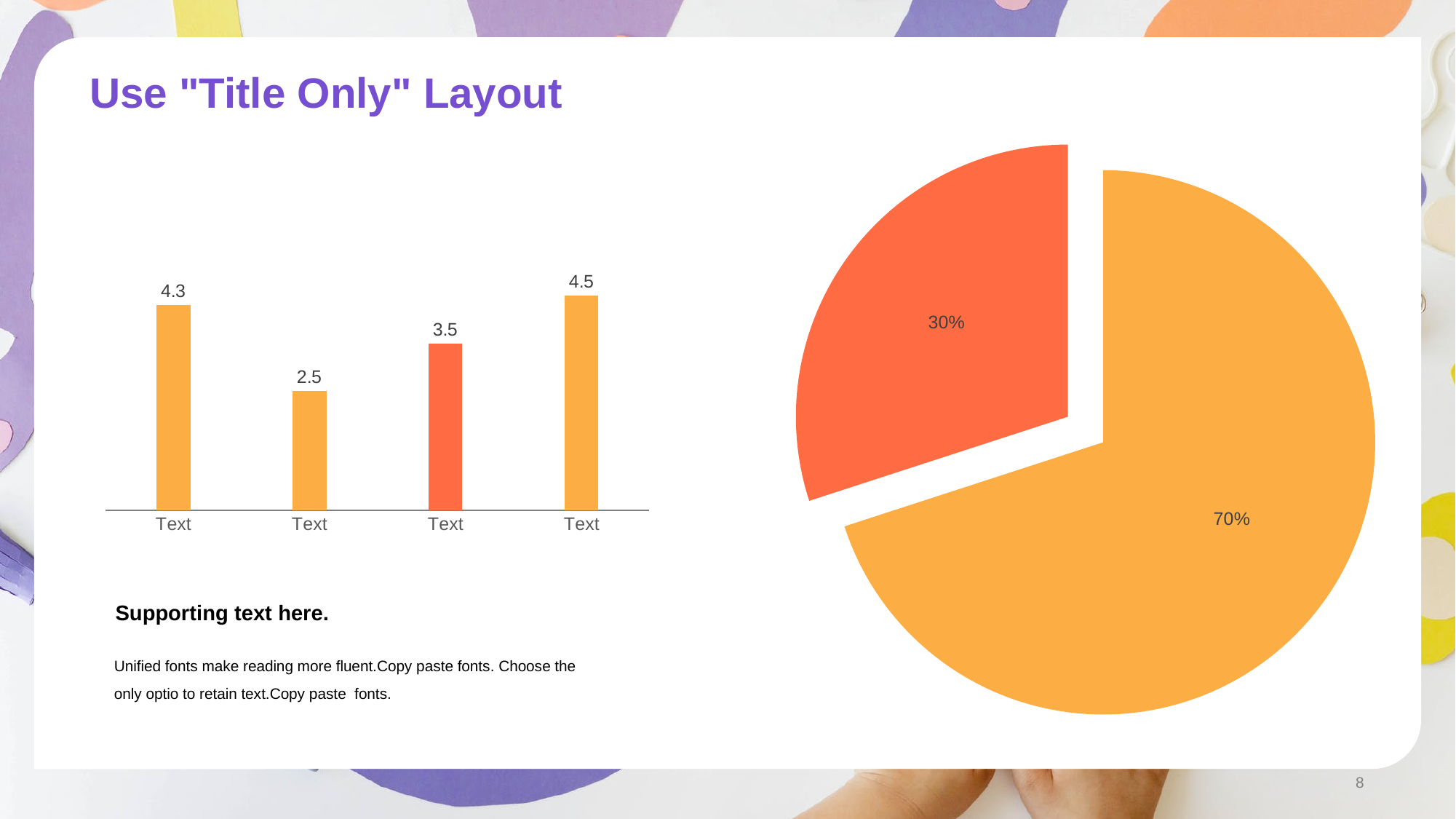
In the bar chart on the left, what is the difference between the fourth bar and the second bar? 2 What type of chart is on the right side of the slide? pie chart In the bar chart on the left, which bar has the lowest value? the second bar (2.5) In the bar chart on the left, which bar has the highest value? the fourth bar (4.5) In the pie chart on the right, how many slices are there? 2 In the bar chart on the left, how many bars are there? 4 What type of chart is on the left side of the slide? bar chart In the bar chart on the left, what is the value of the second bar? 2.5 In the bar chart on the left, which is larger, the first bar or the third bar? the first bar In the bar chart on the left, what is the value of the first bar? 4.3 In the bar chart on the left, what is the value of the third bar? 3.5 In the pie chart on the right, what share does the larger slice represent? 70%